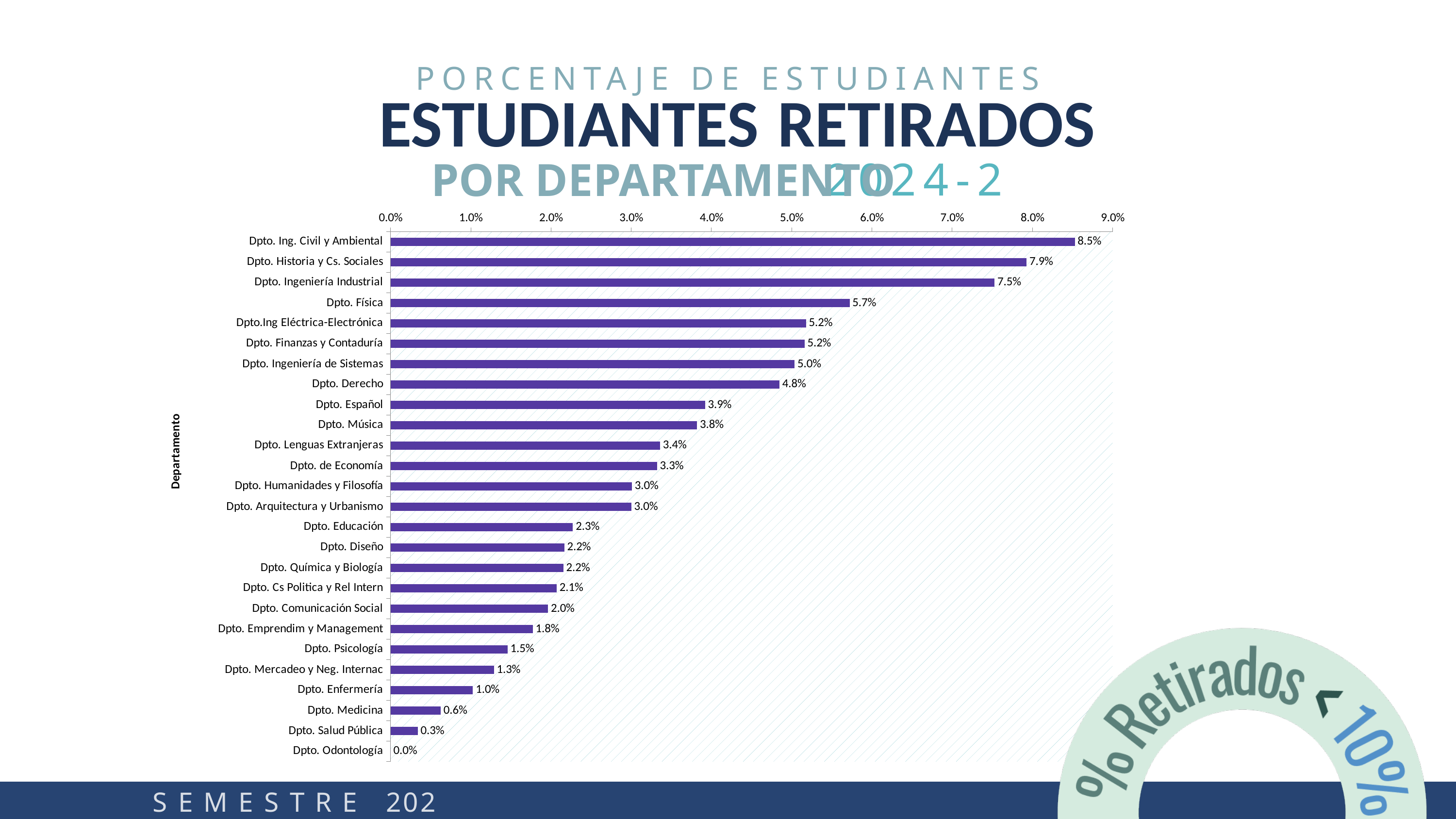
Which has a larger value, Dpto. Física or Dpto. Ingeniería de Sistemas? Dpto. Física What is the value shown for Dpto. Enfermería? 1.0% What is the label of the vertical axis of the chart? Departamento How many departments are shown in the chart? 26 Which department has the lowest percentage of withdrawn students? Dpto. Odontología What is the value shown for Dpto. Derecho? 4.8% Is the value for Dpto. Español greater or less than 3.0%? greater What is the difference between the values for Dpto. Medicina and Dpto. Salud Pública? 0.3% Which department has the highest percentage of withdrawn students? Dpto. Ing. Civil y Ambiental What type of chart is shown on the slide? Bar chart What is the percentage of withdrawn students for Dpto. Ing. Civil y Ambiental? 8.5% What is the difference between the values for Dpto. Historia y Cs. Sociales and Dpto. Ingeniería Industrial? 0.4%